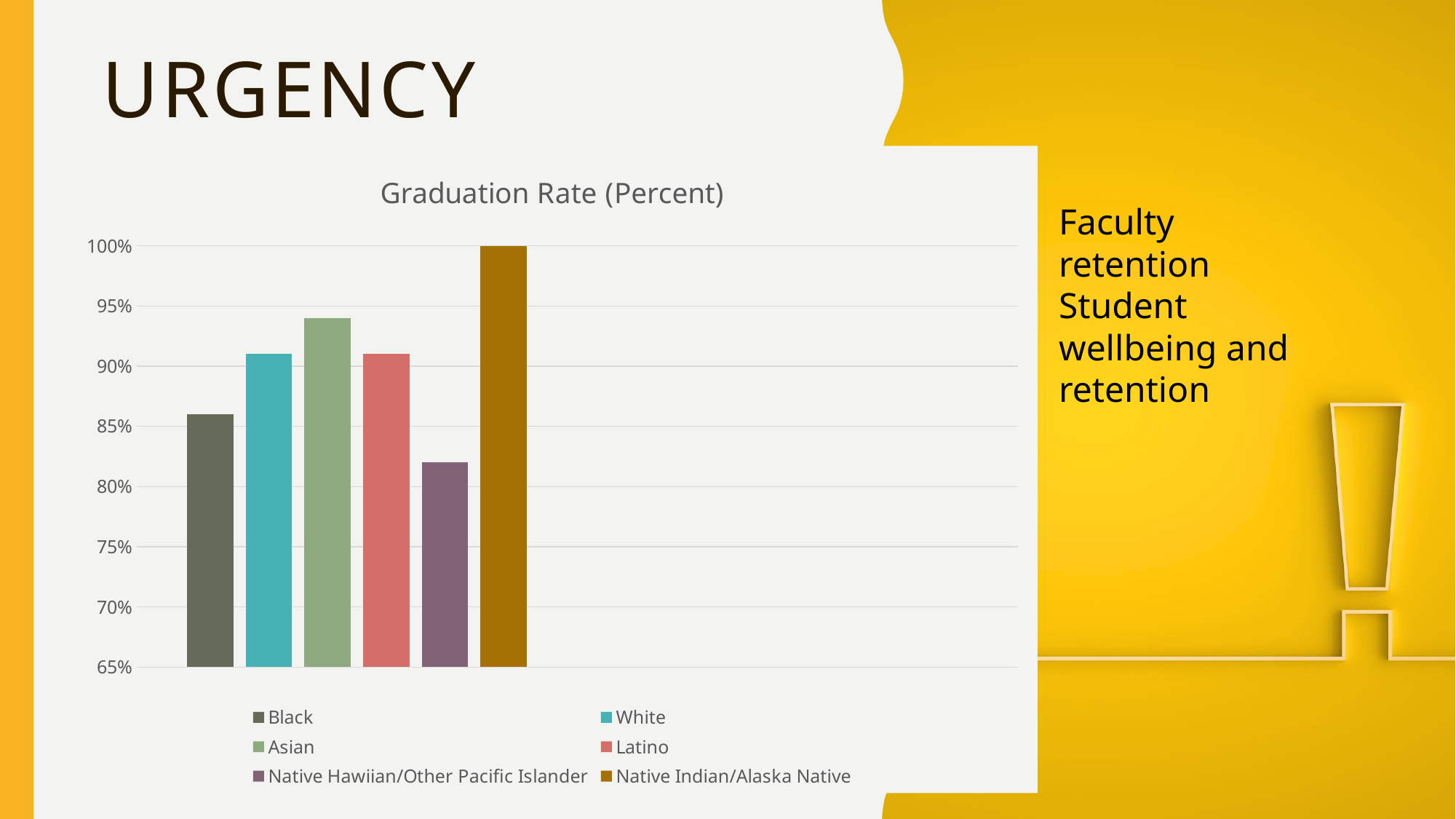
How many entries does the legend list? 6 How many groups are plotted in the chart? 6 Which group has the highest graduation rate in the chart? Native Indian/Alaska Native Which has a higher graduation rate, Black or Native Hawiian/Other Pacific Islander? Black Is the graduation rate for Black greater or less than 85%? greater What kind of chart is shown on the slide? bar chart Which group has the lowest graduation rate in the chart? Native Hawiian/Other Pacific Islander What is the graduation rate for Native Indian/Alaska Native? 100% Which has a higher graduation rate, Asian or Black? Asian What is the title of the chart? Graduation Rate (Percent) Is the graduation rate for Asian greater or less than 90%? greater Is the graduation rate for Native Hawiian/Other Pacific Islander greater or less than 85%? less